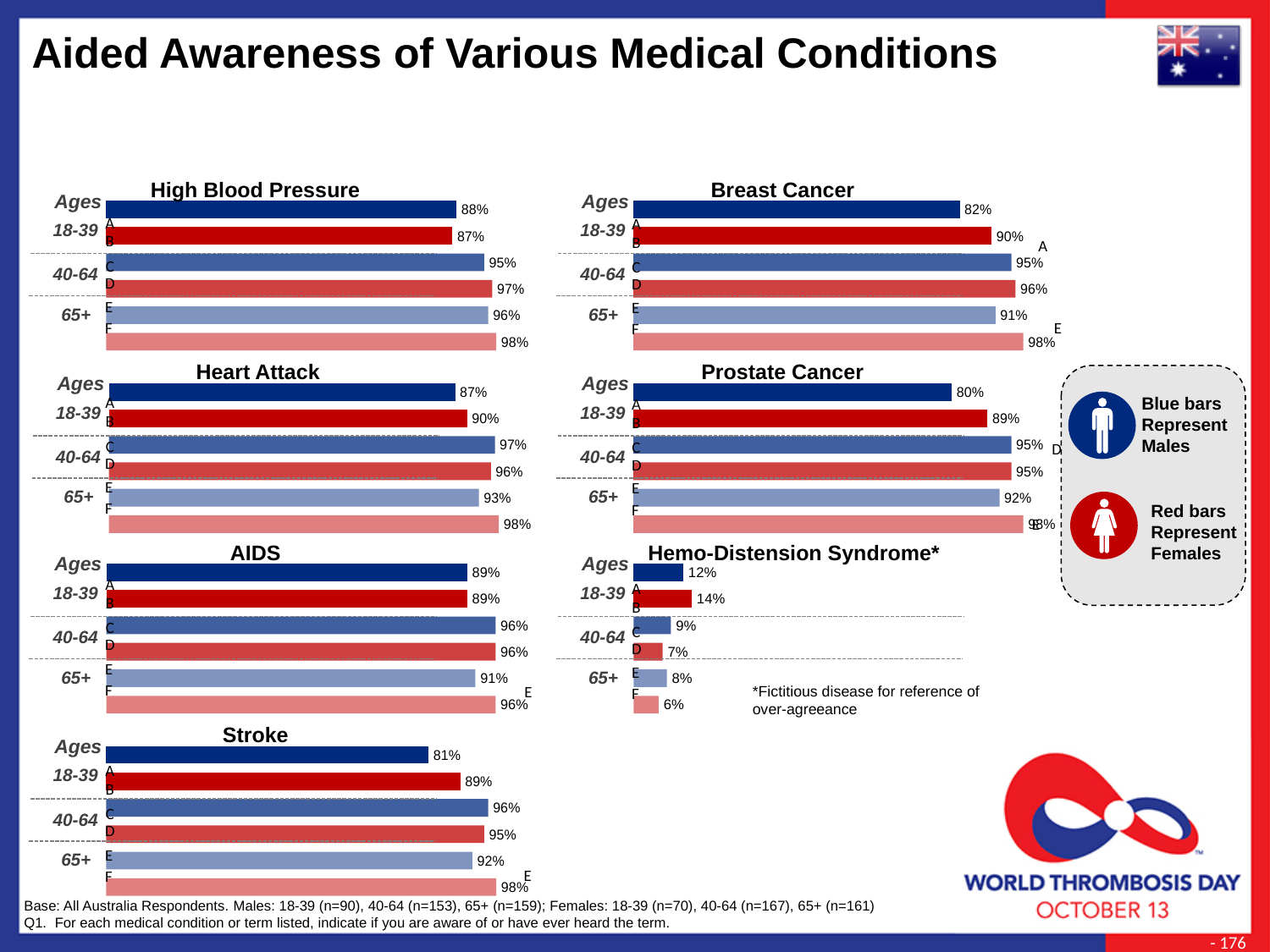
In the Breast Cancer chart, what is the difference between females aged 18-39 and males aged 18-39? 8 percentage points In the Hemo-Distension Syndrome* chart, which bar has the highest value? Females 18-39 (14%) How many medical conditions are charted on the slide? 7 In the Hemo-Distension Syndrome* chart, do the female values rise or fall from the 18-39 group to the 65+ group? Fall In the Breast Cancer chart, what is the value for females aged 65+? 98% In the AIDS chart, what is the value for males aged 65+? 91% According to the legend, what do the red bars represent? Females What type of chart is used for each medical condition on the slide? Bar chart In the High Blood Pressure chart, what is the value for males aged 18-39? 88% In the Prostate Cancer chart, which is larger: the value for males aged 18-39 or females aged 18-39? Females 18-39 (89%) In the Stroke chart, which age group and gender has the lowest value? Males 18-39 (81%) In the Hemo-Distension Syndrome* chart, what is the value for males aged 18-39? 12%